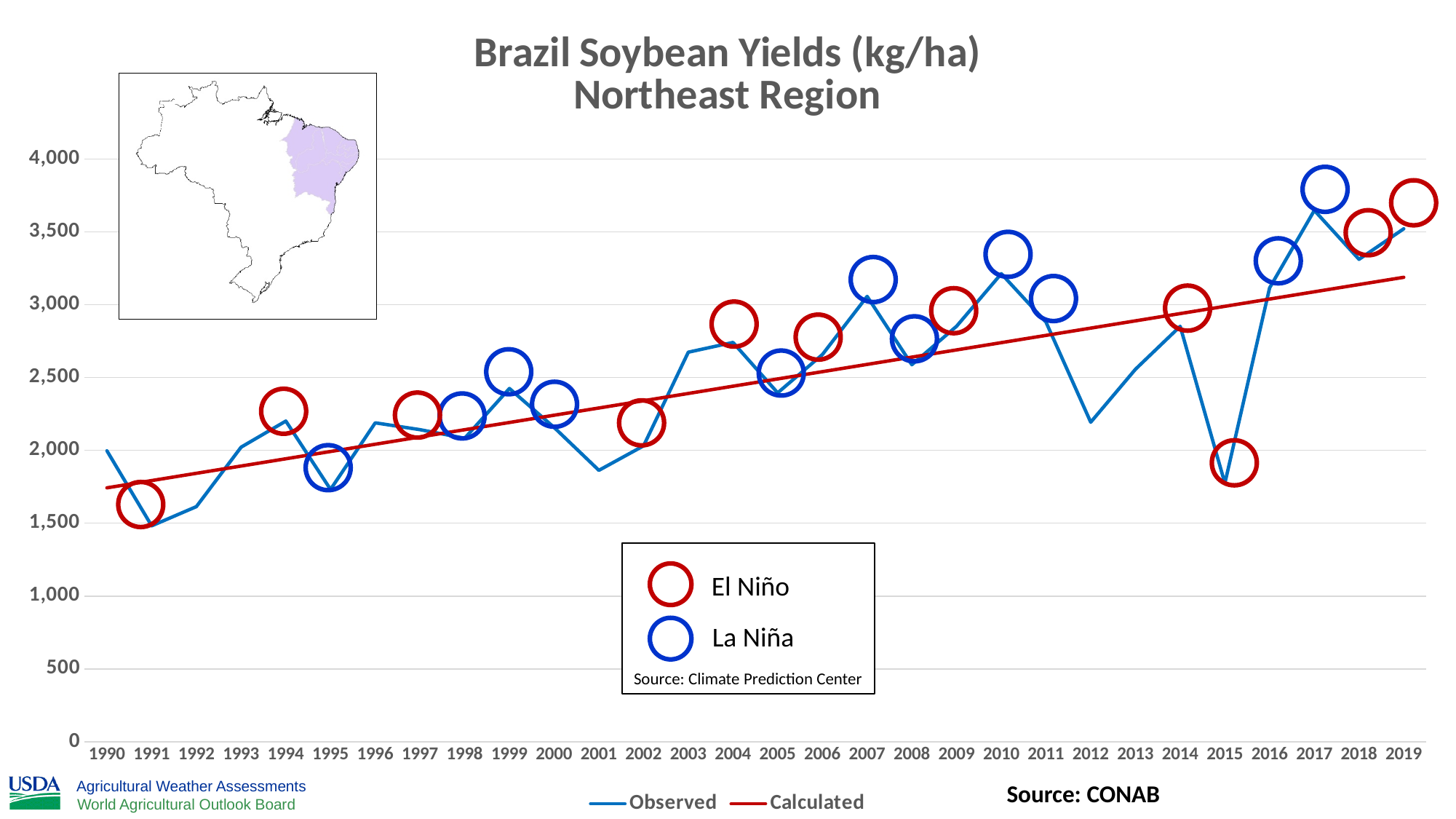
Is the observed yield for 2012 greater or less than 2,500? less Which year has the lowest observed soybean yield? 1991 What is the title of the chart? Brazil Soybean Yields (kg/ha) Northeast Region Which year has the highest observed soybean yield? 2017 Is the observed yield for 1991 greater or less than 2,000? less How many series does the legend at the bottom of the chart list? 2 Does the Calculated trend line rise or fall from 1990 to 2019? rise Is the observed yield for 2015 greater or less than 2,000? less What kind of chart is shown on the slide? line chart How many years are shown on the x axis? 30 Which year has the larger observed yield, 2015 or 2017? 2017